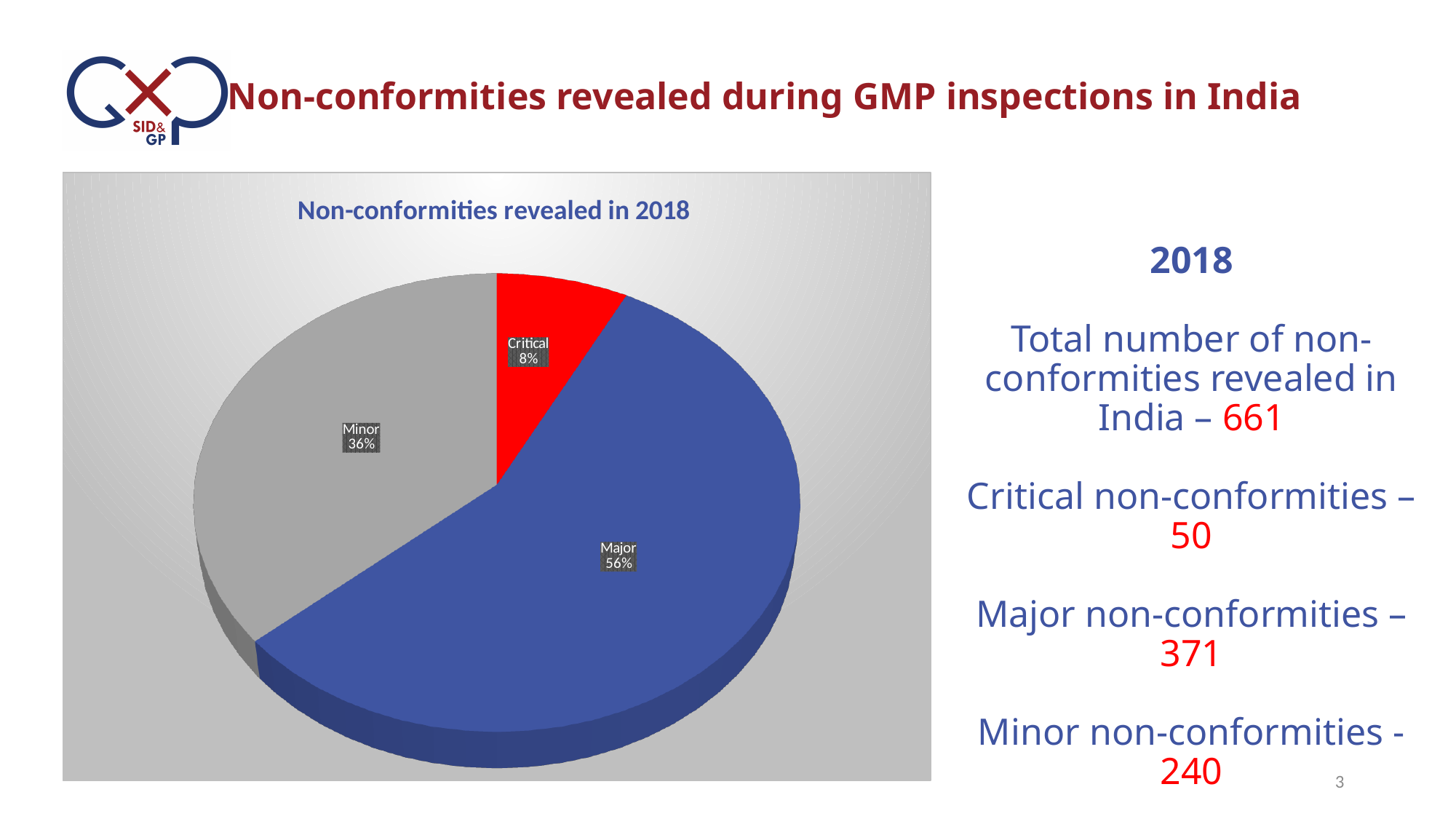
What share of the pie does the Critical slice represent? 8% What share of the pie does the Major slice represent? 56% What is the title of the chart? Non-conformities revealed in 2018 What kind of chart is shown on the slide? Pie chart Which category has the largest slice of the pie? Major What is the difference in percentage points between the Minor and Critical slices? 28 Which slice is larger, Minor or Critical? Minor How many slices does the pie chart have? 3 Which category has the smallest slice of the pie? Critical What share of the pie does the Minor slice represent? 36% What is the difference in percentage points between the Major and Minor slices? 20 What colour is the Critical slice of the pie? Red